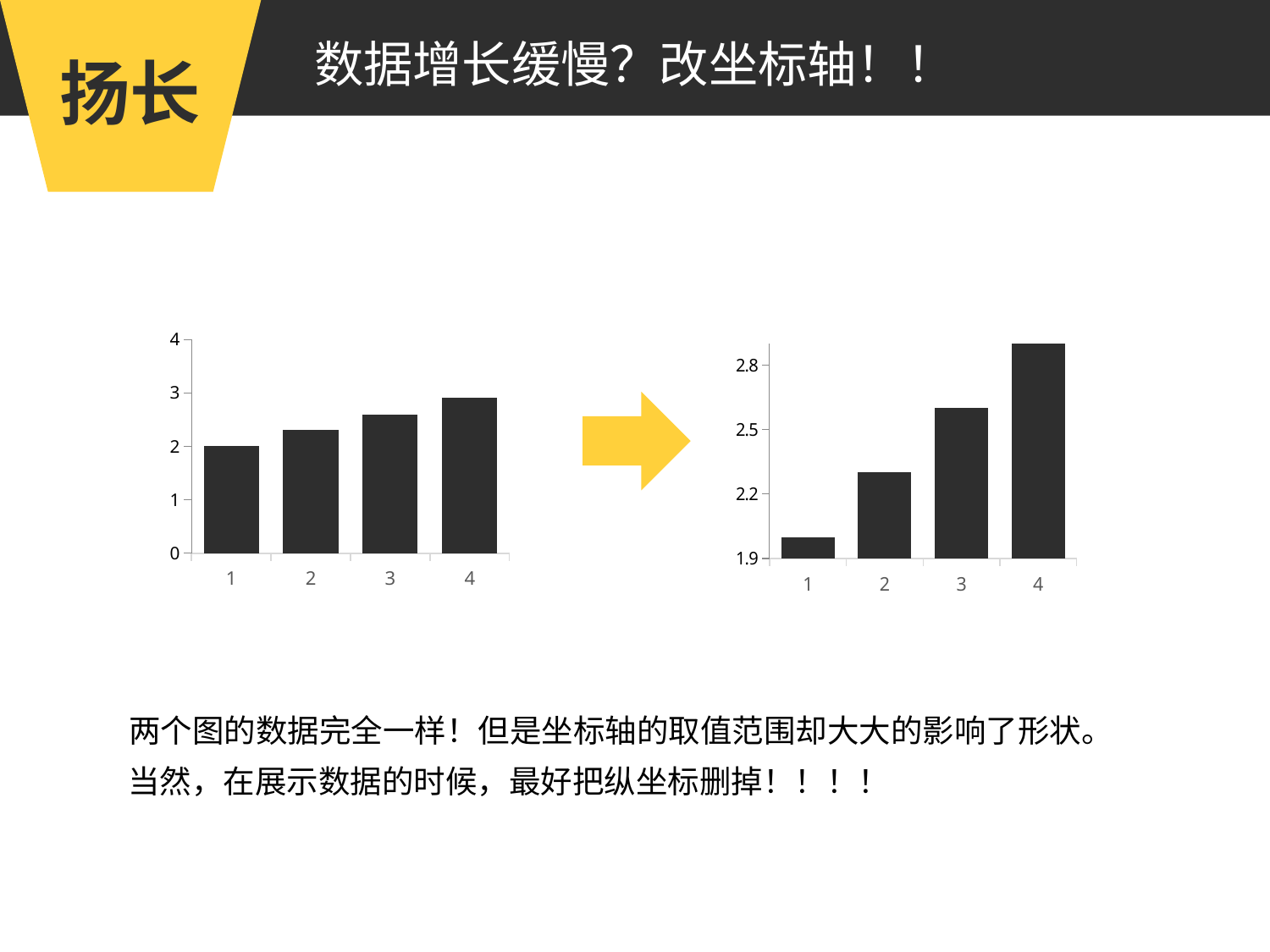
What kind of chart is the left chart? bar chart In the left chart, do the bars rise or fall from category 1 to category 4? rise In the left chart, which category has the highest bar? 4 In the right chart, is the value for category 4 greater or less than 2.8? greater How many charts are shown on the slide? 2 How many bars does the left chart have? 4 In the left chart, what is the value for category 1? 2 In the left chart, is the value for category 3 greater or less than 2? greater In the right chart, which category has the highest bar? 4 What kind of chart is the right chart? bar chart In the left chart, which category has the lowest bar? 1 In the right chart, is the value for category 2 greater or less than 2.5? less